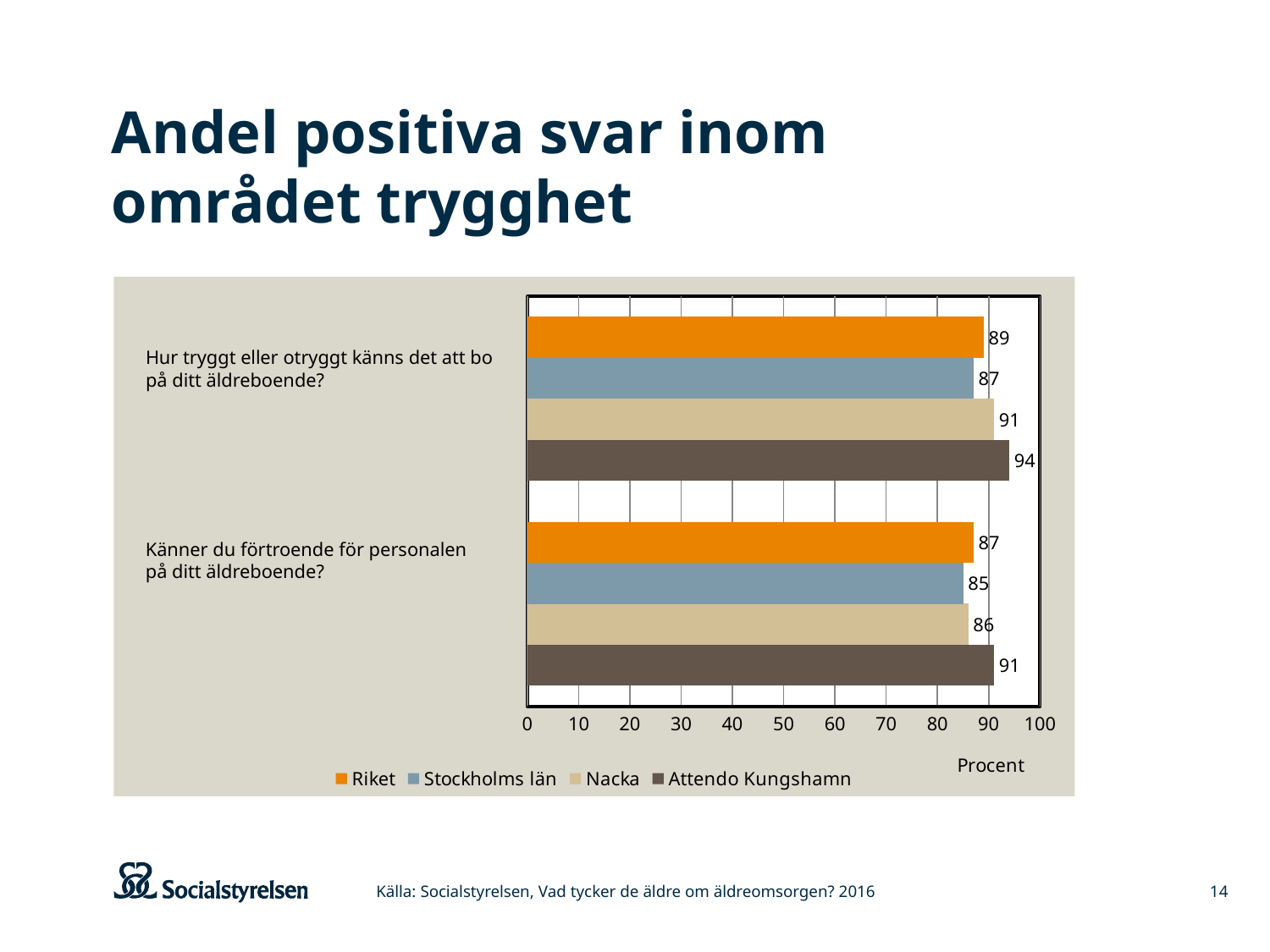
What is the label of the horizontal axis? Procent Which series has the lowest value on the question "Hur tryggt eller otryggt känns det att bo på ditt äldreboende?"? Stockholms län Which series has the highest value on the question "Känner du förtroende för personalen på ditt äldreboende?"? Attendo Kungshamn Which is larger: Nacka on "Hur tryggt eller otryggt känns det att bo på ditt äldreboende?" or Nacka on "Känner du förtroende för personalen på ditt äldreboende?"? Hur tryggt eller otryggt känns det att bo på ditt äldreboende? What value is shown for Riket on the question "Känner du förtroende för personalen på ditt äldreboende?"? 87 What value is shown for Stockholms län on the question "Känner du förtroende för personalen på ditt äldreboende?"? 85 How many series does the legend list? 4 What is the difference between Attendo Kungshamn and Riket on the question "Hur tryggt eller otryggt känns det att bo på ditt äldreboende?"? 5 What kind of chart is shown on the slide? Bar chart What is the difference between Attendo Kungshamn and Stockholms län on the question "Känner du förtroende för personalen på ditt äldreboende?"? 6 What value is shown for Attendo Kungshamn on the question "Hur tryggt eller otryggt känns det att bo på ditt äldreboende?"? 94 What value is shown for Nacka on the question "Hur tryggt eller otryggt känns det att bo på ditt äldreboende?"? 91